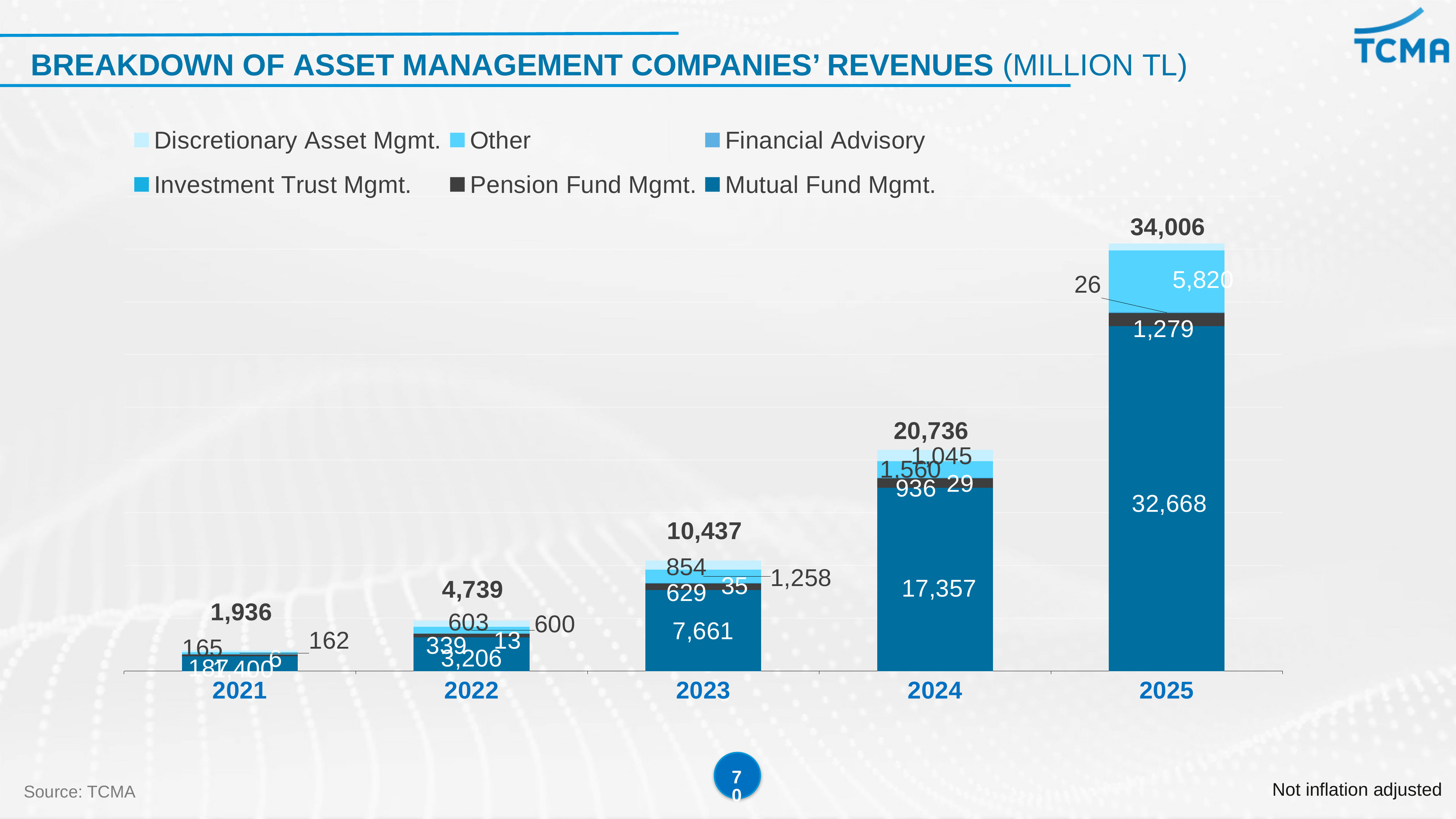
What is the Other revenue for 2025? 5,820 Which year has the highest total revenue? 2025 How many years are shown on the x axis of the chart? 5 What is the difference between the total revenue in 2025 and in 2024? 13,270 What is the total revenue shown for 2025? 34,006 What is the Pension Fund Mgmt. revenue for 2023? 629 What is the Mutual Fund Mgmt. revenue for 2024? 17,357 Which year has the lowest total revenue? 2021 How many series does the legend list? 6 What kind of chart is shown on the slide? Stacked bar chart Do the total revenues rise or fall from 2021 to 2025? Rise What is the total revenue shown for 2022? 4,739